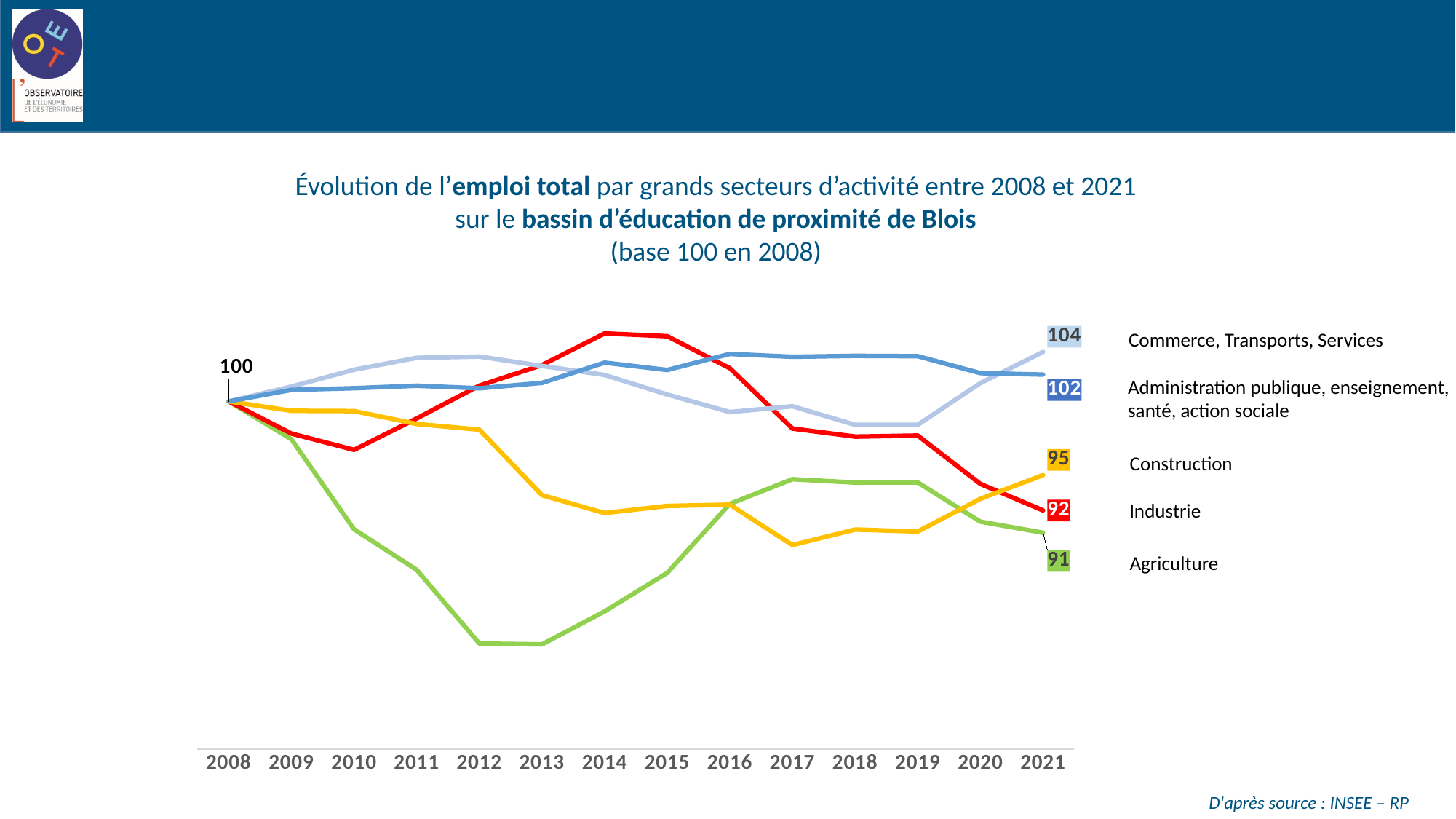
Which sector has the highest index value in 2021? Commerce, Transports, Services What is the difference between the 2021 values of Commerce, Transports, Services and Agriculture? 13 How many series (sectors) does the chart show? 5 Does the Industrie line rise or fall between 2014 and 2021? fall What is the 2021 index value for Industrie? 92 What is the 2021 index value for Agriculture? 91 What is the 2021 index value for Commerce, Transports, Services? 104 What is the 2021 index value for Construction? 95 What kind of chart is shown on the slide? line chart How many years are shown along the x axis? 14 Which sector has the lowest index value in 2021? Agriculture In 2021, which is higher: Construction or Industrie? Construction